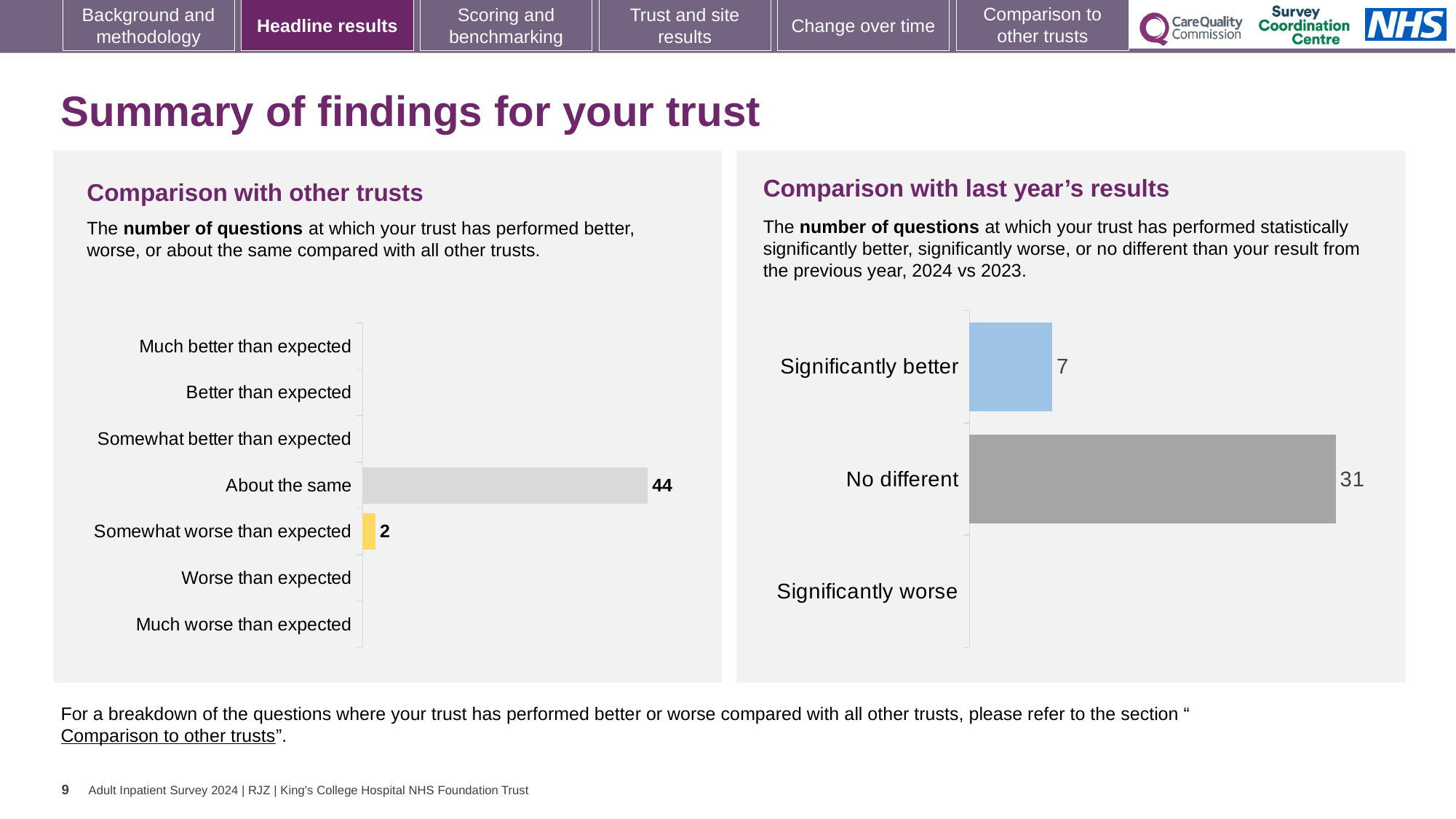
In the 'Comparison with other trusts' chart, what is the value for 'Somewhat worse than expected'? 2 In the 'Comparison with last year's results' chart, what is the difference between the values for 'No different' and 'Significantly better'? 24 In the 'Comparison with other trusts' chart, which category has the highest value? About the same In the 'Comparison with other trusts' chart, what is the value for 'About the same'? 44 In the 'Comparison with other trusts' chart, what is the difference between the values for 'About the same' and 'Somewhat worse than expected'? 42 In the 'Comparison with last year's results' chart, which category has the highest value? No different In the 'Comparison with last year's results' chart, what is the value for 'Significantly better'? 7 How many categories are listed on the axis of the 'Comparison with last year's results' chart? 3 In the 'Comparison with last year's results' chart, what is the value for 'No different'? 31 In the 'Comparison with last year's results' chart, what colour is the bar for 'Significantly better'? Light blue What kind of chart is the 'Comparison with other trusts' chart? Bar chart How many categories are listed on the axis of the 'Comparison with other trusts' chart? 7